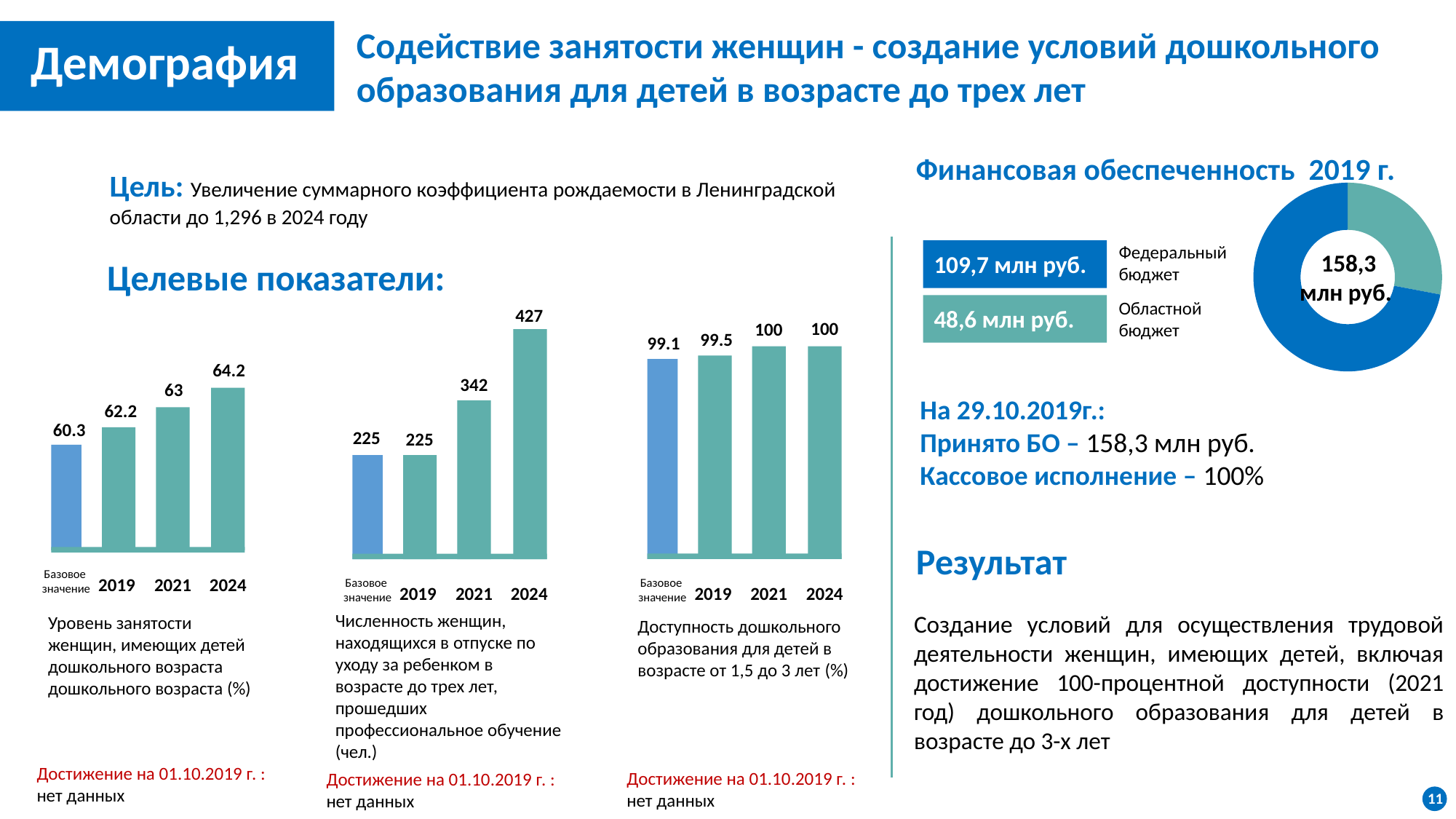
In the donut chart (Финансовая обеспеченность 2019 г.), which is larger: Федеральный бюджет or Областной бюджет? Федеральный бюджет In the left bar chart (Уровень занятости женщин, имеющих детей дошкольного возраста), what is the value for 2021? 63 In the middle bar chart (Численность женщин), what is the difference between the 2024 and 2021 values? 85 In the middle bar chart (Численность женщин, находящихся в отпуске по уходу за ребенком), what is the value for 2024? 427 What type of chart is used for Финансовая обеспеченность 2019 г.? donut (pie) chart In the middle bar chart (Численность женщин), which category has the highest value? 2024 In the right bar chart (Доступность дошкольного образования), which category has the lowest value? Базовое значение In the donut chart (Финансовая обеспеченность 2019 г.), what is the value for Федеральный бюджет? 109,7 млн руб. How many categories are shown in the middle bar chart (Численность женщин)? 4 In the left bar chart (Уровень занятости женщин), what is the базовое значение? 60.3 In the right bar chart (Доступность дошкольного образования), what is the value for 2019? 99.5 In the left bar chart (Уровень занятости женщин), do the values rise or fall from the базовое значение to 2024? rise